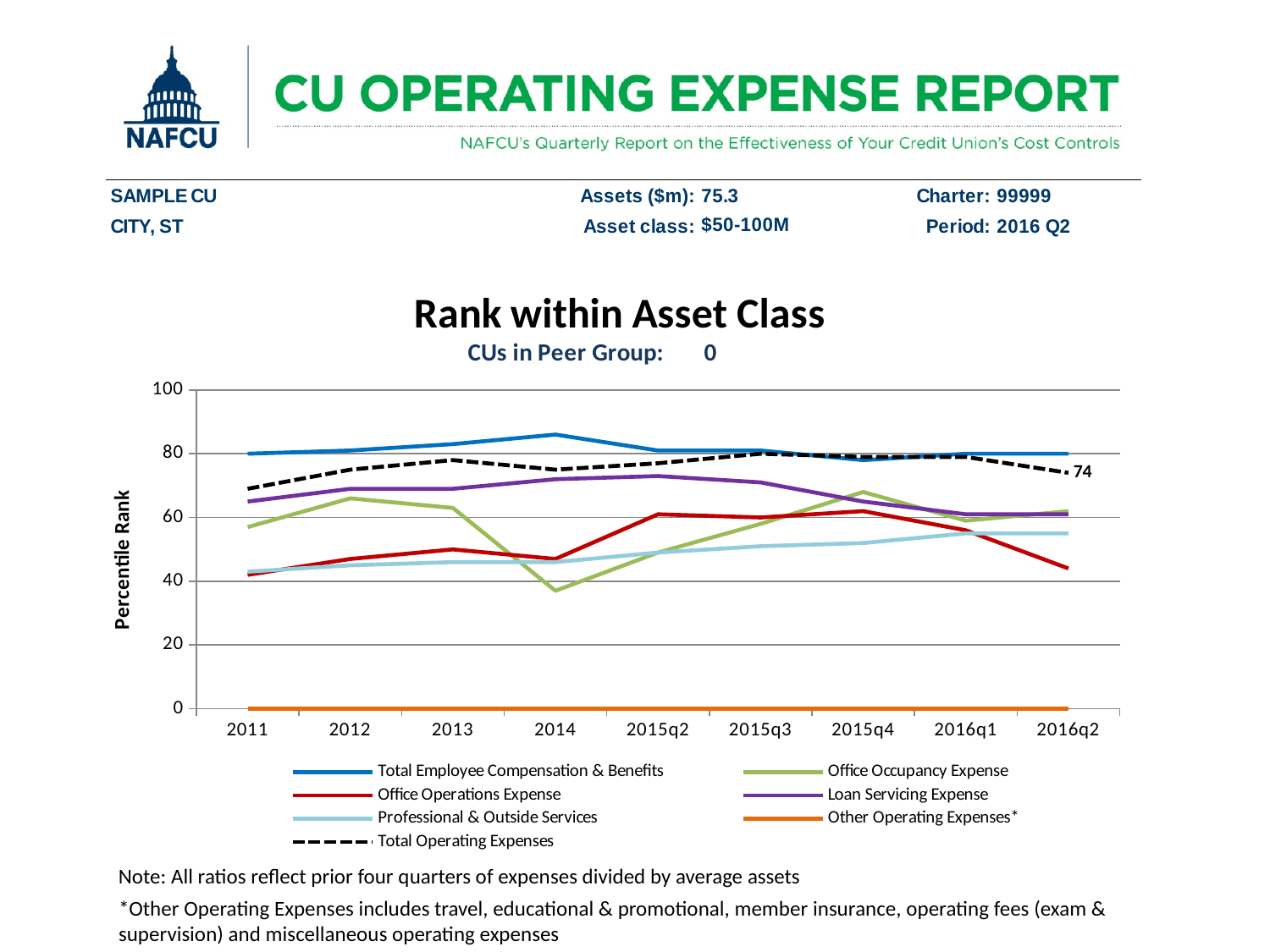
How many periods are shown along the x axis? 9 Which series has the highest value at 2011? Total Employee Compensation & Benefits What kind of chart is shown on the slide? line chart Which series has the lowest value at 2016q2? Other Operating Expenses* How many series does the legend list? 7 Is the value for Office Occupancy Expense at 2014 greater or less than 40? less What is the value of Total Operating Expenses at 2016q2? 74 Does Office Operations Expense rise or fall from 2015q4 to 2016q2? fall At 2011, which is larger: Total Employee Compensation & Benefits or Office Operations Expense? Total Employee Compensation & Benefits What is the value of Other Operating Expenses* at 2016q2? 0 Is the value for Total Employee Compensation & Benefits at 2014 greater or less than 80? greater Is the value for Loan Servicing Expense at 2015q2 greater or less than 60? greater